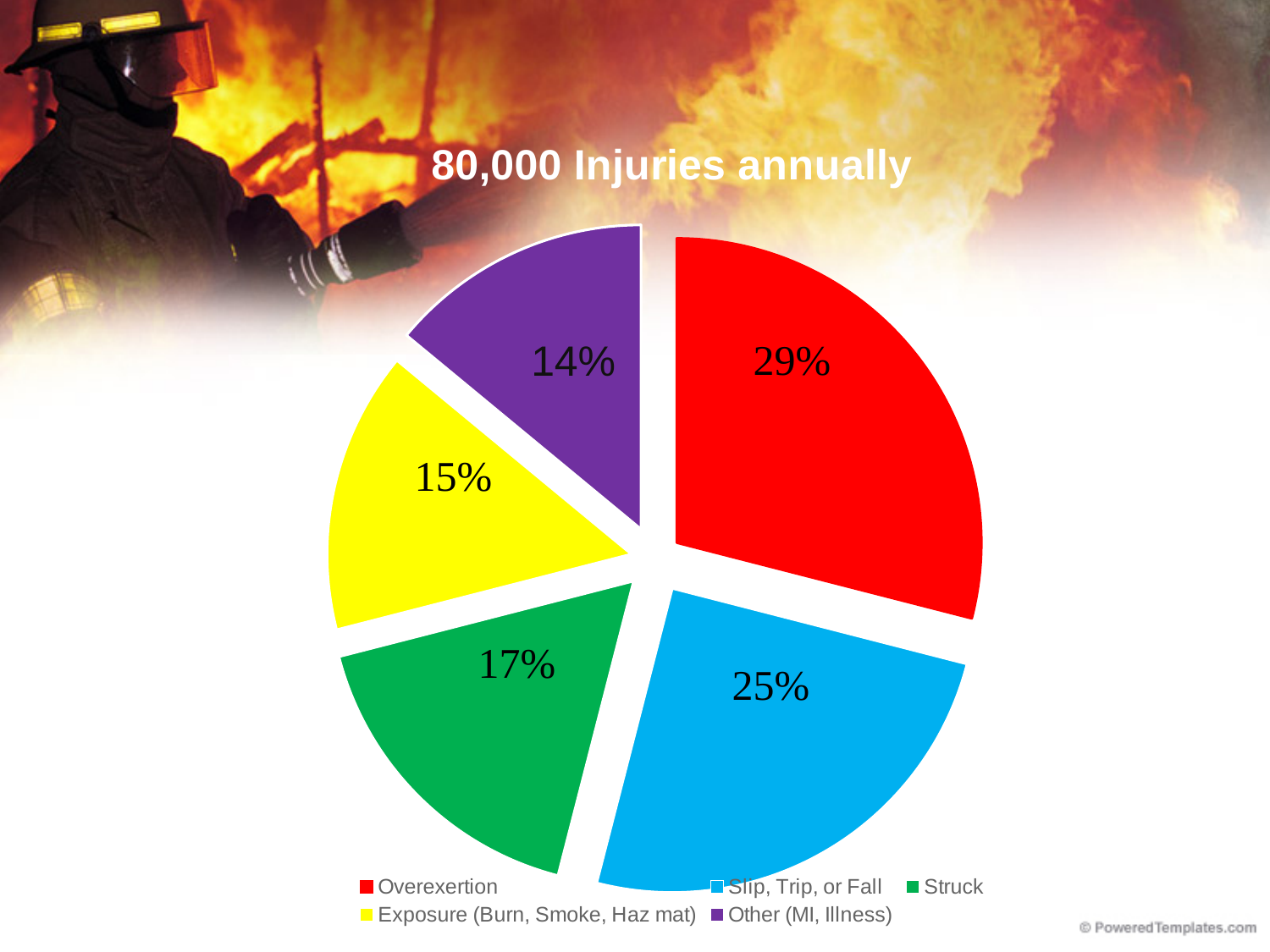
What kind of chart is shown on the slide? pie chart What share of injuries is attributed to Other (MI, Illness)? 14% What share of injuries is attributed to Exposure (Burn, Smoke, Haz mat)? 15% What is the title of the chart? 80,000 Injuries annually What share of injuries is attributed to Overexertion? 29% Which category accounts for the smallest share of injuries? Other (MI, Illness) What is the difference in percentage points between Overexertion and Slip, Trip, or Fall? 4 What share of injuries is attributed to Slip, Trip, or Fall? 25% Which category accounts for the largest share of injuries? Overexertion Which is larger, the share for Struck or the share for Exposure (Burn, Smoke, Haz mat)? Struck How many categories does the pie chart show? 5 What share of injuries is attributed to Struck? 17%